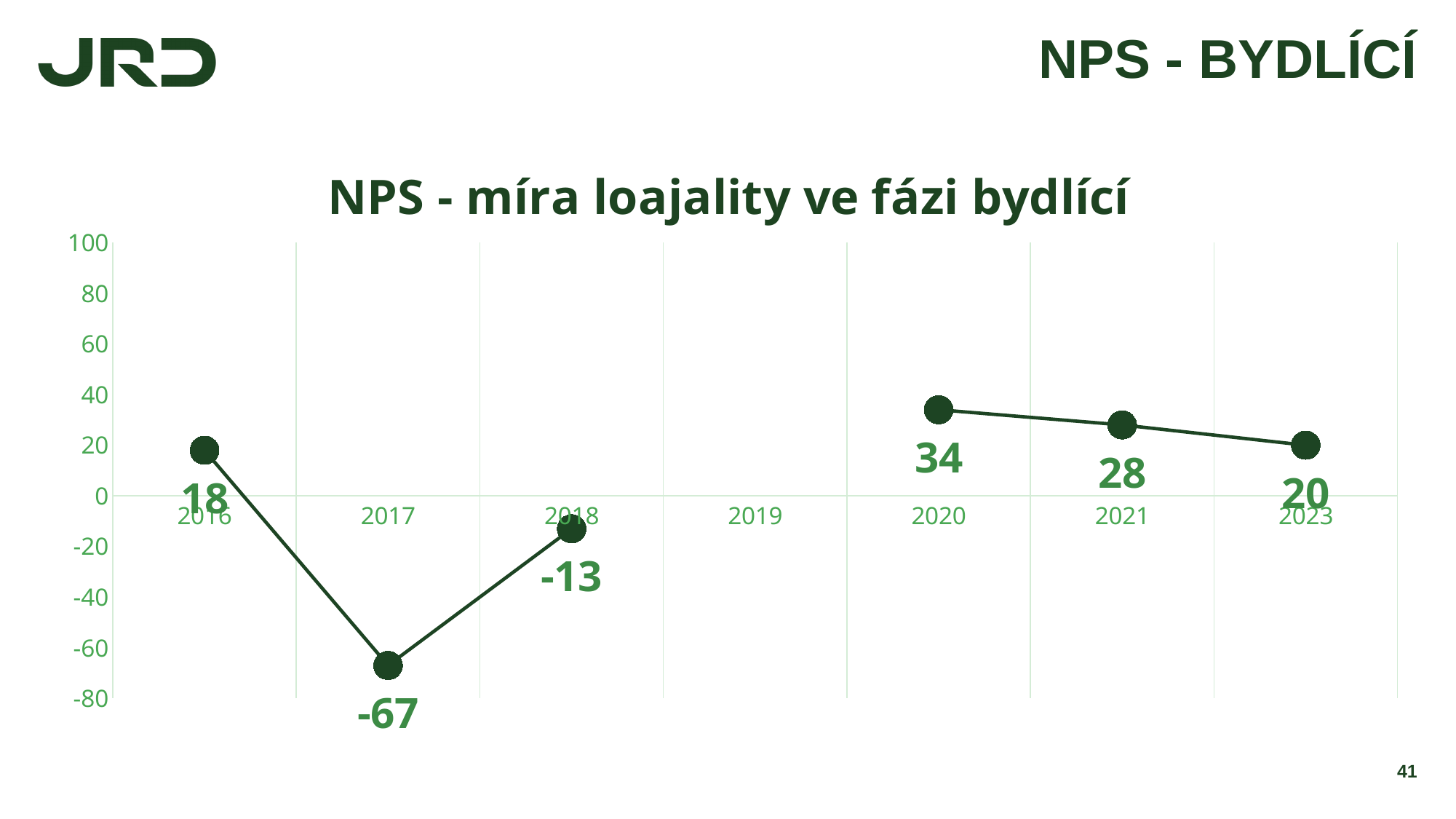
What kind of chart is shown on the slide? line chart Do the NPS values rise or fall from 2020 to 2023? fall How many data points are plotted on the chart? 6 Which is larger, the NPS value for 2016 or for 2023? 2023 What is the NPS value for 2017? -67 What is the NPS value for 2023? 20 Which year has the lowest NPS value? 2017 Which year has the highest NPS value? 2020 What is the difference between the NPS values for 2016 and 2017? 85 Is the NPS value for 2018 greater or less than 0? less What is the difference between the NPS values for 2020 and 2021? 6 What is the NPS value for 2020? 34